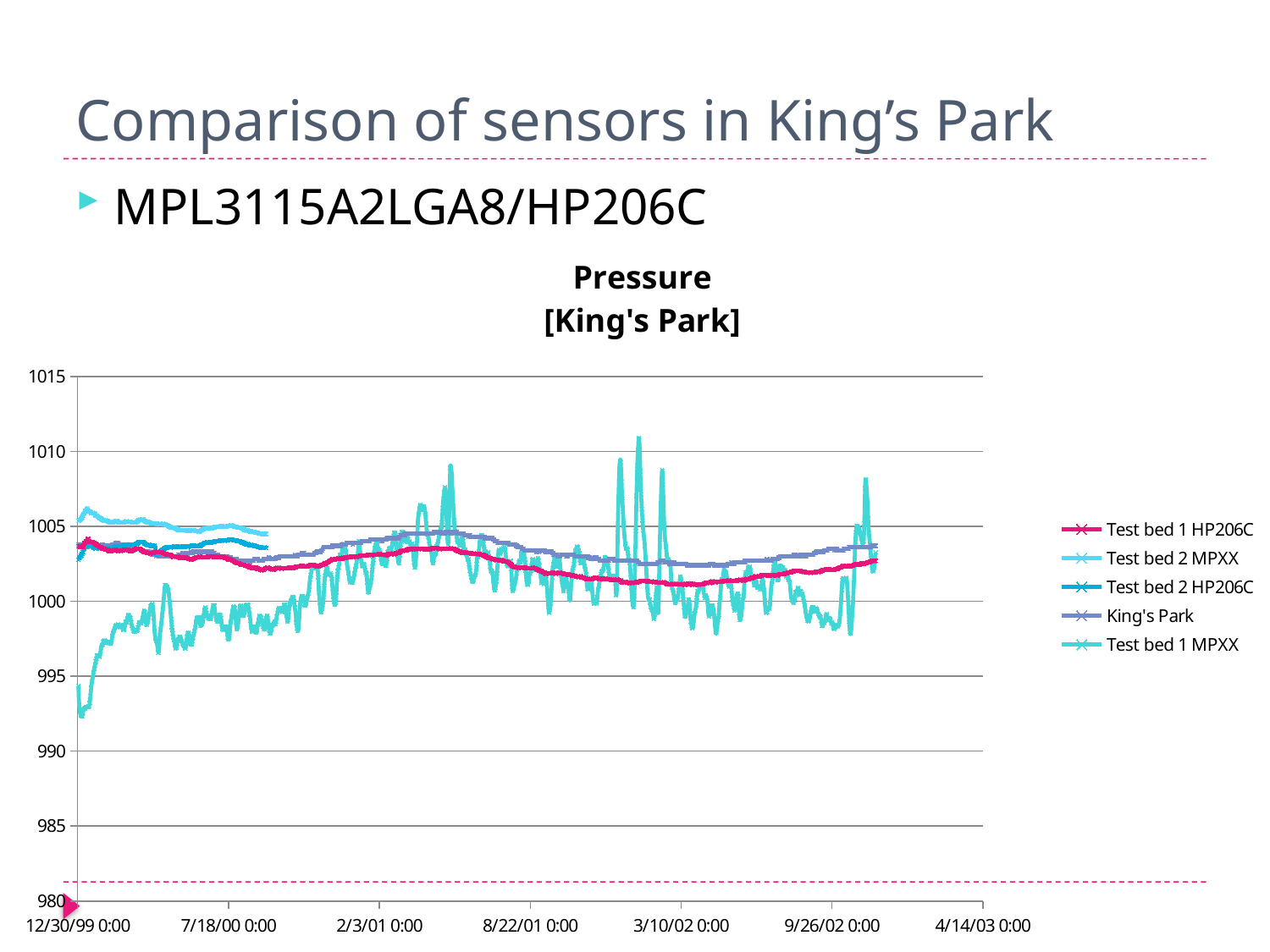
Which series is drawn in pink/magenta in the legend? Test bed 1 HP206C Is the lowest value of Test bed 1 MPXX greater or less than 995? less How many date labels are shown on the x axis? 7 Which series reaches the highest peak on the chart? Test bed 1 MPXX Is the highest peak of Test bed 1 MPXX greater or less than 1005? greater Is the value of Test bed 2 MPXX at 12/30/99 0:00 greater or less than 1000? greater What is the title of the chart? Pressure [King's Park] What kind of chart is shown on the slide? line chart How many series does the legend list? 5 Which series reaches the lowest value on the chart? Test bed 1 MPXX